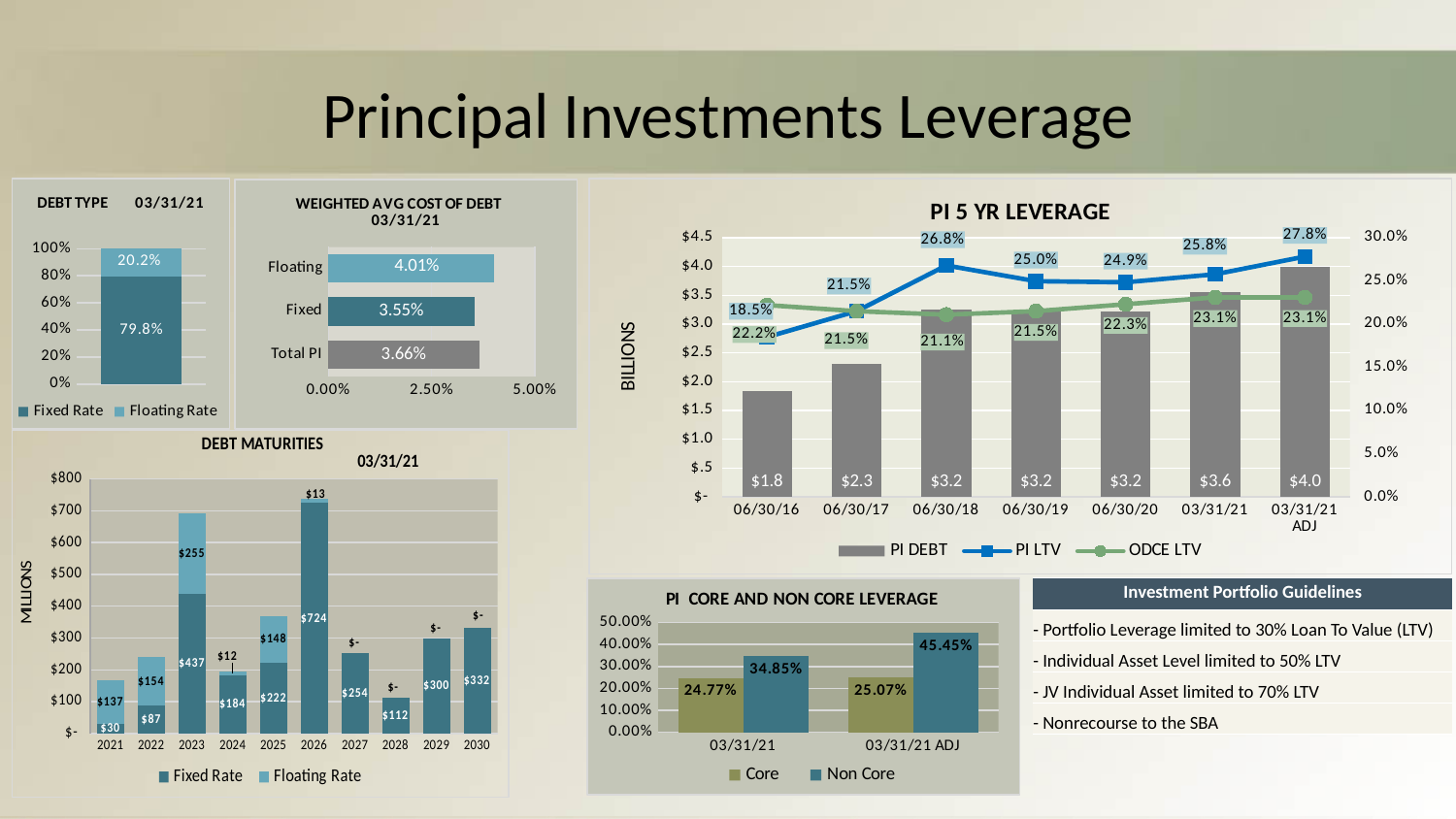
In the PI 5 YR LEVERAGE chart, what is the difference between PI DEBT at 03/31/21 ADJ and at 06/30/16? $2.2 In the PI 5 YR LEVERAGE chart, how many series does the legend list? 3 In the DEBT MATURITIES chart, how many years are shown on the x axis? 10 In the PI CORE AND NON CORE LEVERAGE chart, what is the Non Core value for 03/31/21 ADJ? 45.45% In the PI 5 YR LEVERAGE chart, what is the PI LTV value at 06/30/18? 26.8% In the DEBT MATURITIES chart, what is the Fixed Rate value for 2026? $724 In the DEBT MATURITIES chart, what is the total of the stacked bar for 2023? $692 In the WEIGHTED AVG COST OF DEBT chart, what is the value for Floating? 4.01% In the PI CORE AND NON CORE LEVERAGE chart, which is larger at 03/31/21: Core or Non Core? Non Core In the WEIGHTED AVG COST OF DEBT chart, which category has the lowest value? Fixed In the DEBT TYPE chart, what percentage is Fixed Rate? 79.8% In the PI 5 YR LEVERAGE chart, what is the PI DEBT value for 03/31/21 ADJ? $4.0